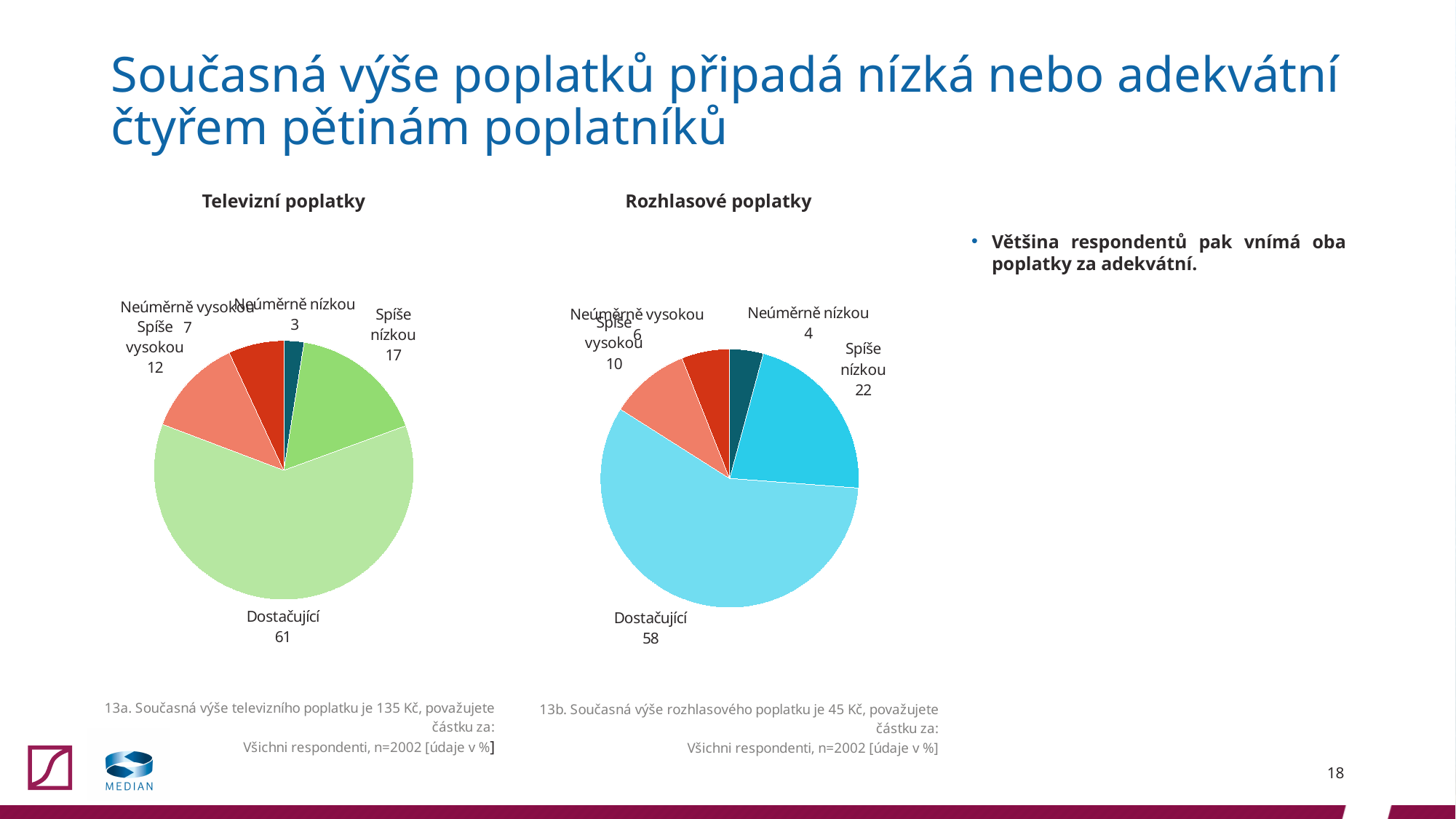
How many slices does the Televizní poplatky pie chart have? 5 In the Televizní poplatky chart, what is the value for Dostačující? 61 In the Rozhlasové poplatky chart, what is the difference between Spíše nízkou and Spíše vysokou? 12 What is the title of the chart on the left? Televizní poplatky What type of chart is used for Rozhlasové poplatky? Pie chart Which is larger: Spíše nízkou in the Televizní poplatky chart or Spíše nízkou in the Rozhlasové poplatky chart? Rozhlasové poplatky What is the difference between the Dostačující values in the Televizní poplatky chart and the Rozhlasové poplatky chart? 3 In the Televizní poplatky chart, what is the value for Spíše vysokou? 12 In the Rozhlasové poplatky chart, what is the value for Neúměrně vysokou? 6 In the Rozhlasové poplatky chart, which category has the largest slice? Dostačující In the Televizní poplatky chart, which category has the smallest slice? Neúměrně nízkou In the Rozhlasové poplatky chart, what is the value for Spíše nízkou? 22